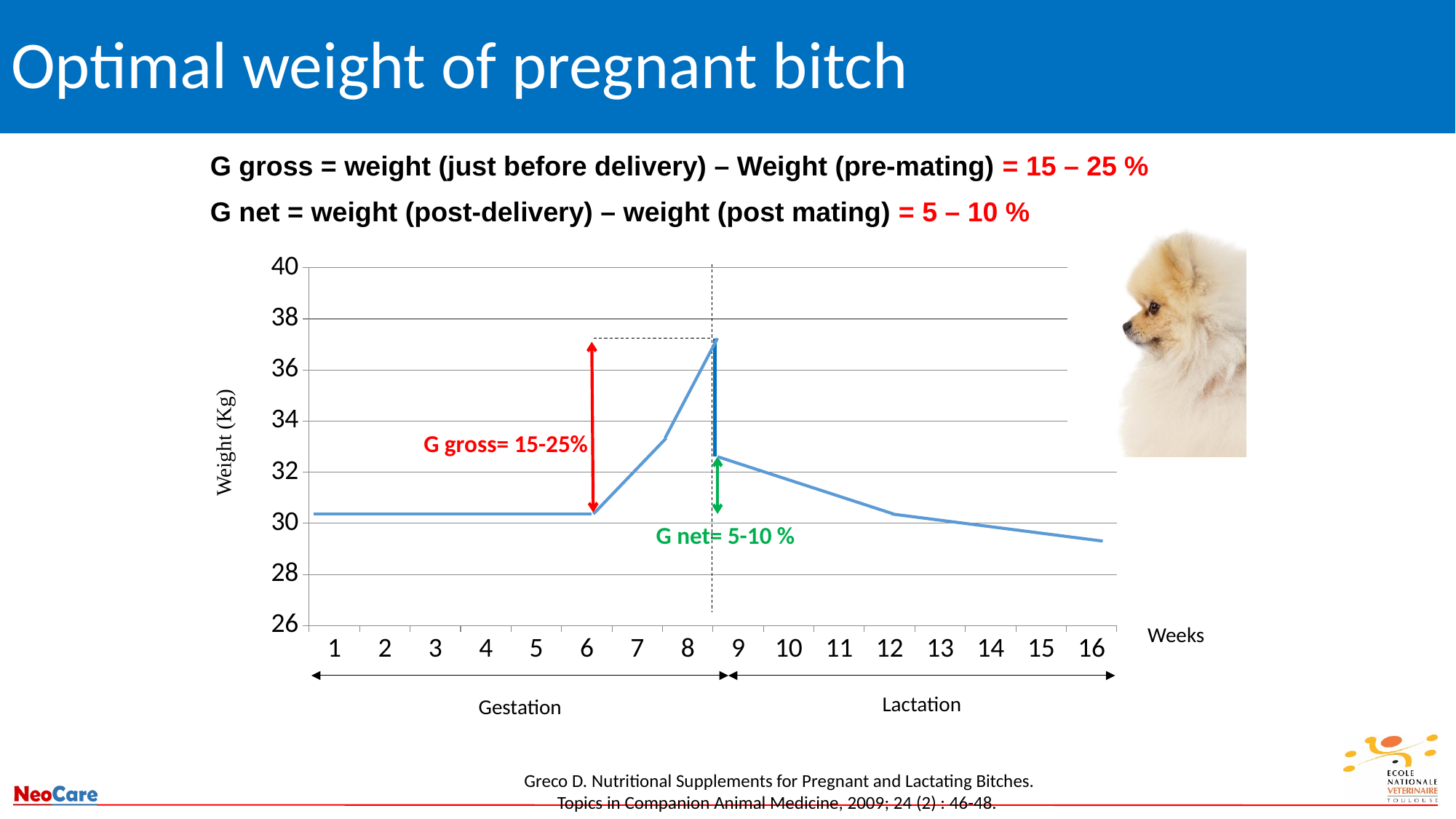
Does the weight rise or fall across the lactation period (weeks 9 to 16)? fall Which is larger, the weight at week 8 or the weight at week 12? week 8 How many week ticks are labelled on the x axis of the chart? 16 Is the weight at week 8 greater or less than 32 kg? greater Is the peak weight reached at the end of gestation greater or less than 36 kg? greater Is the weight at week 16 greater or less than 30 kg? less Does the weight rise or fall between week 6 and week 8? rise What is the label of the y axis of the chart? Weight (Kg) What kind of chart is shown on the slide? line chart What percentage range is given for G gross in the chart annotation? 15-25% Which week has the lowest weight on the chart? 16